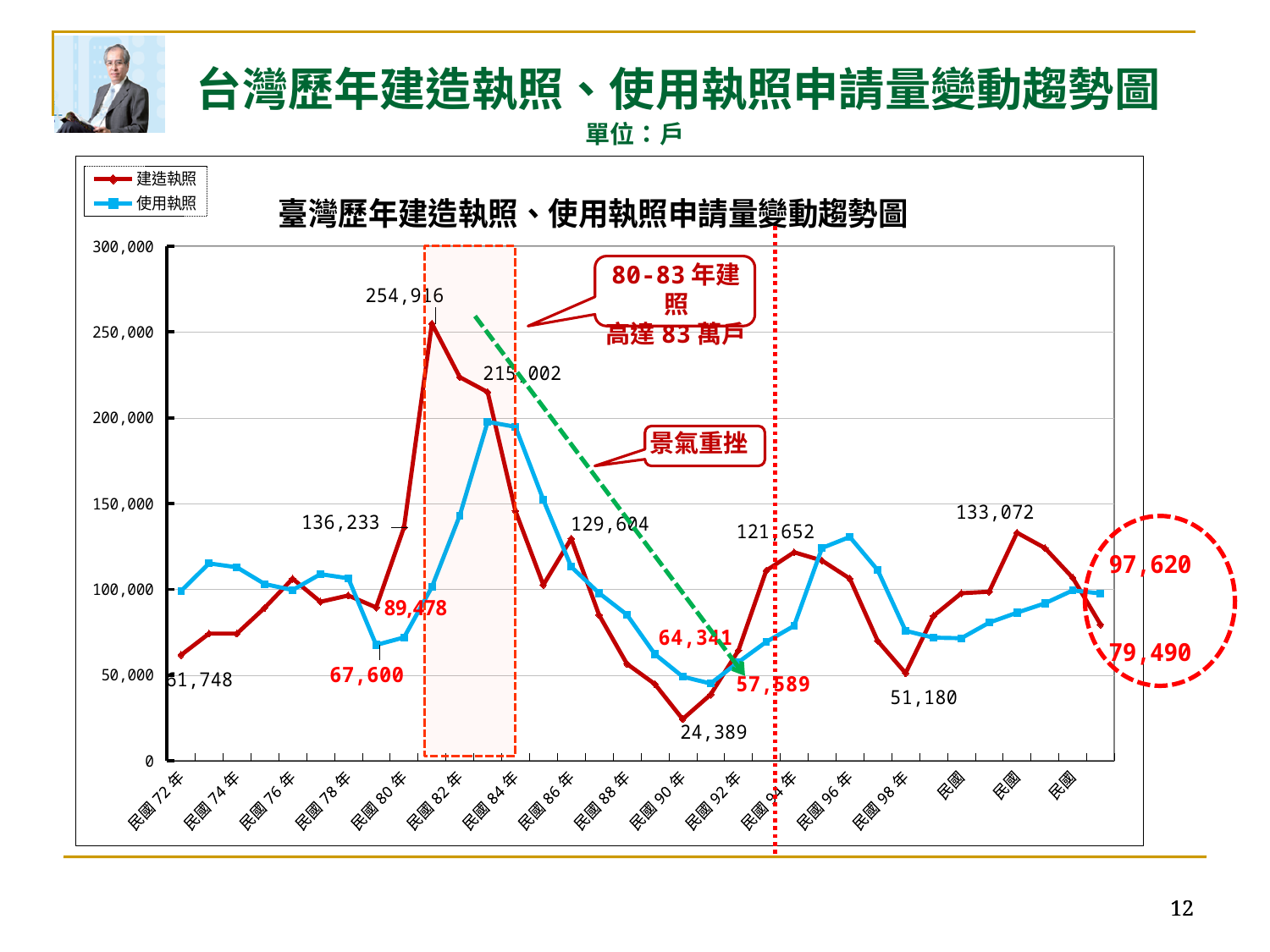
What is the value of 建造執照 at 民國80年? 136,233 What are the two series named in the legend? 建造執照 and 使用執照 What is the lowest labelled value of the 建造執照 series? 24,389 What is the highest labelled value of the 建造執照 series? 254,916 What unit is stated for the values on the slide? 戶 What kind of chart is shown on the slide? line chart What is the value of 建造執照 at 民國72年? 61,748 What is the difference between the peak 建造執照 value of 254,916 and the low of 24,389? 230,527 What is the difference between the labelled values 254,916 and 215,002 on the 建造執照 line? 39,914 How many series does the legend list? 2 Is the value of 使用執照 at 民國80年 greater or less than 100,000? less At 民國72年, which series has the higher value, 建造執照 or 使用執照? 使用執照